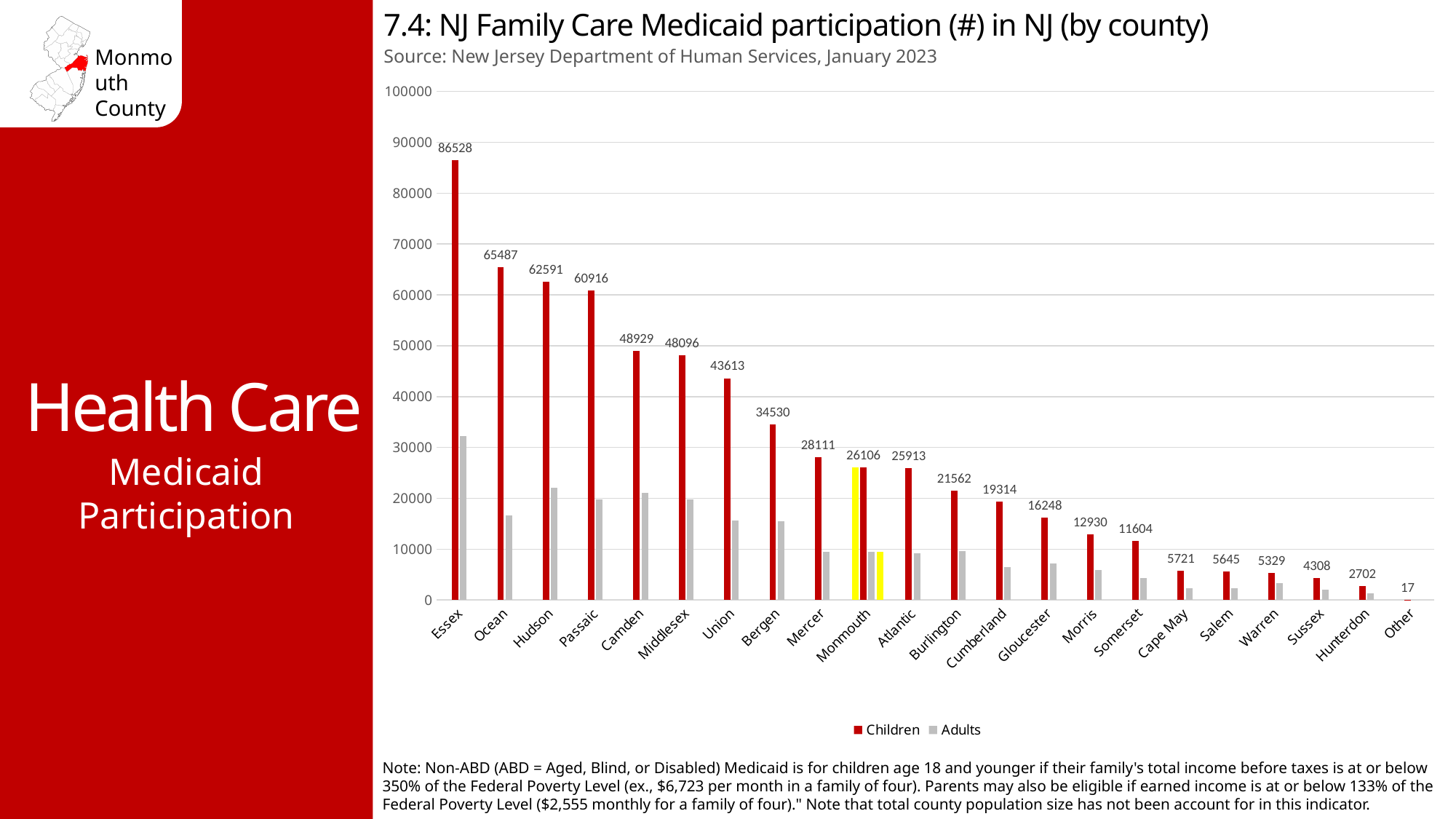
Which has a larger Children value, Camden or Union? Camden What is the Children value for Hunterdon county? 2702 Which category has the lowest Children value? Other How many series does the legend list? 2 Do the Children values rise or fall moving from left to right along the x axis? fall What is the Children value for Monmouth county? 26106 What is the Children value for Essex county? 86528 Is the Adults value for Essex greater or less than 30000? greater Which county has the highest Children value? Essex How many categories are shown on the x axis? 22 What is the difference between the Children values for Essex and Ocean? 21041